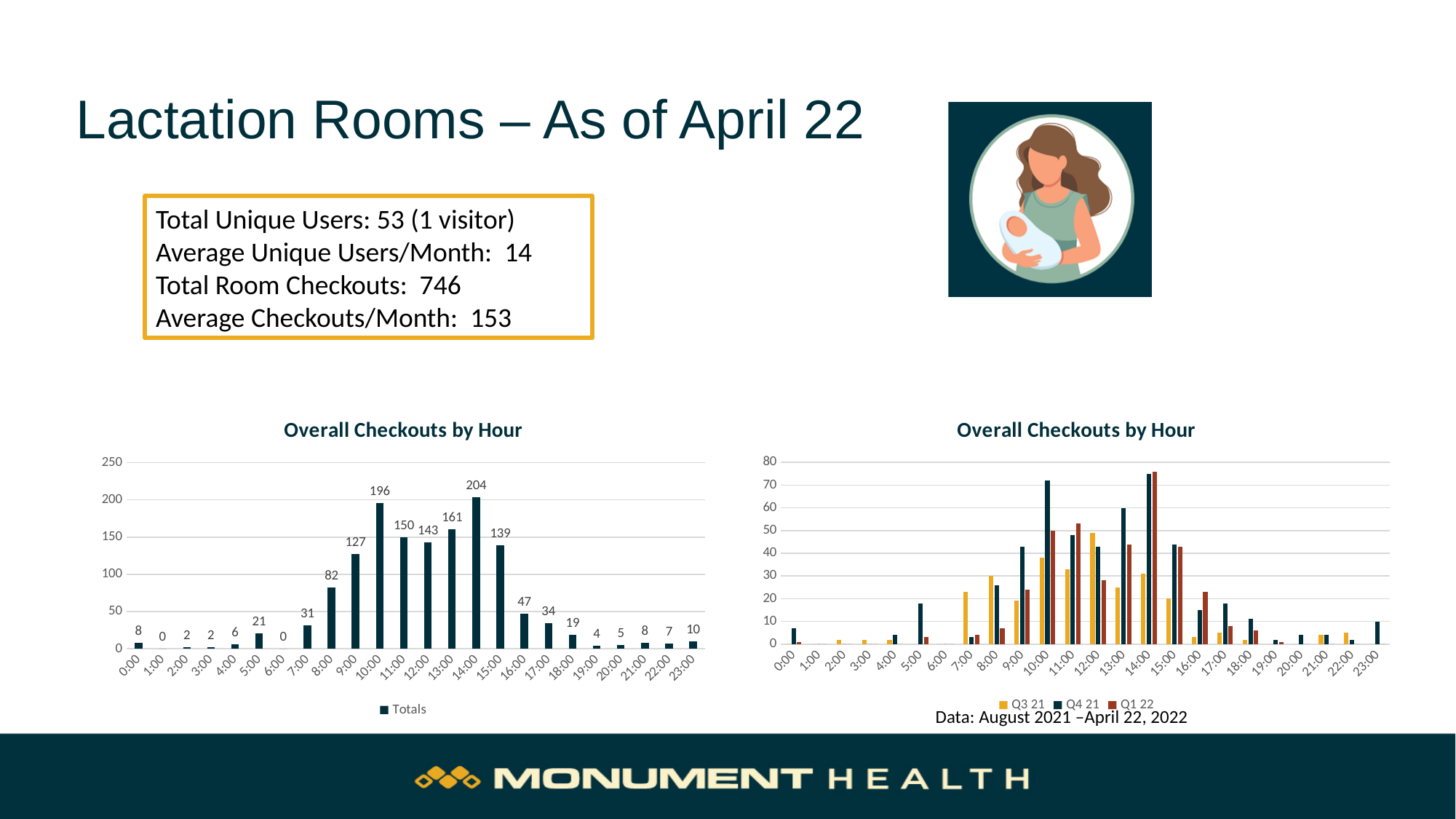
On the left chart, what is the value for 16:00? 47 On the left chart, what is the difference between the values for 14:00 and 10:00? 8 On the left chart, how many hour categories are shown on the x axis? 24 On the left chart, which hour has the highest number of checkouts? 14:00 On the left chart, which is larger, the value for 11:00 or the value for 12:00? 11:00 On the left chart, what is the value for 10:00? 196 On the right chart, is the value for Q3 21 at 7:00 greater or less than 20? greater On the right chart, how many series does the legend list? 3 On the left chart, what is the value for 14:00? 204 On the right chart, is the value for Q4 21 at 10:00 greater or less than 70? greater What kind of chart is the right chart? bar chart On the left chart, what is the name of the single series in the legend? Totals